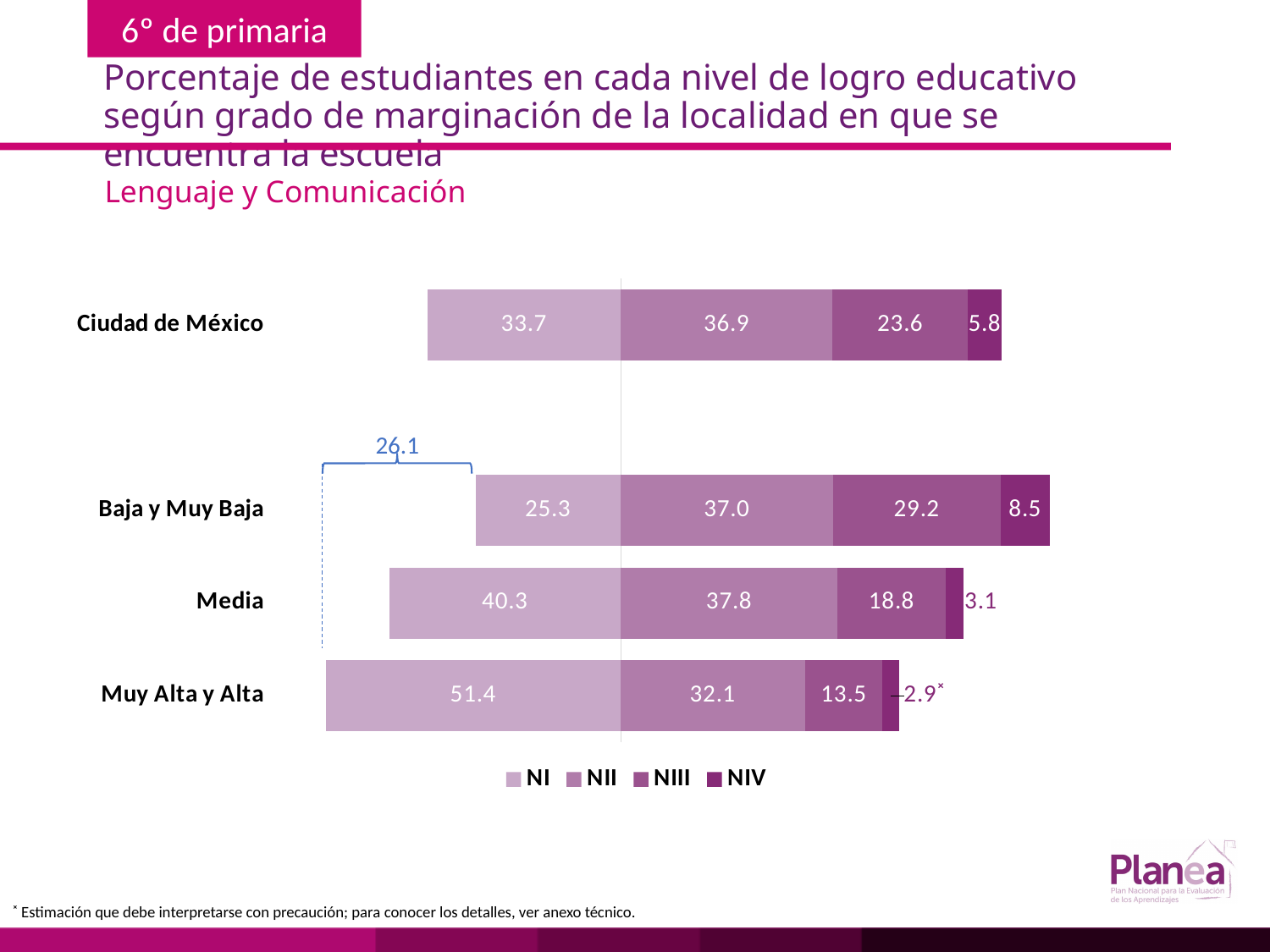
How many categories are shown on the chart? 4 How many series does the legend list? 4 What is the total of the stacked bar for Media? 100.0 What is the NIV value for Baja y Muy Baja? 8.5 Which is larger: the NIII value for Baja y Muy Baja or the NIII value for Ciudad de México? Baja y Muy Baja What is the NIII value for Muy Alta y Alta? 13.5 Which category has the highest NI value? Muy Alta y Alta What is the difference between the NI value for Muy Alta y Alta and the NI value for Baja y Muy Baja? 26.1 What percentage of students in Ciudad de México are at level NI? 33.7 Which category has the lowest NIV value? Muy Alta y Alta What is the NII value for Media? 37.8 What kind of chart is shown on the slide? Stacked bar chart